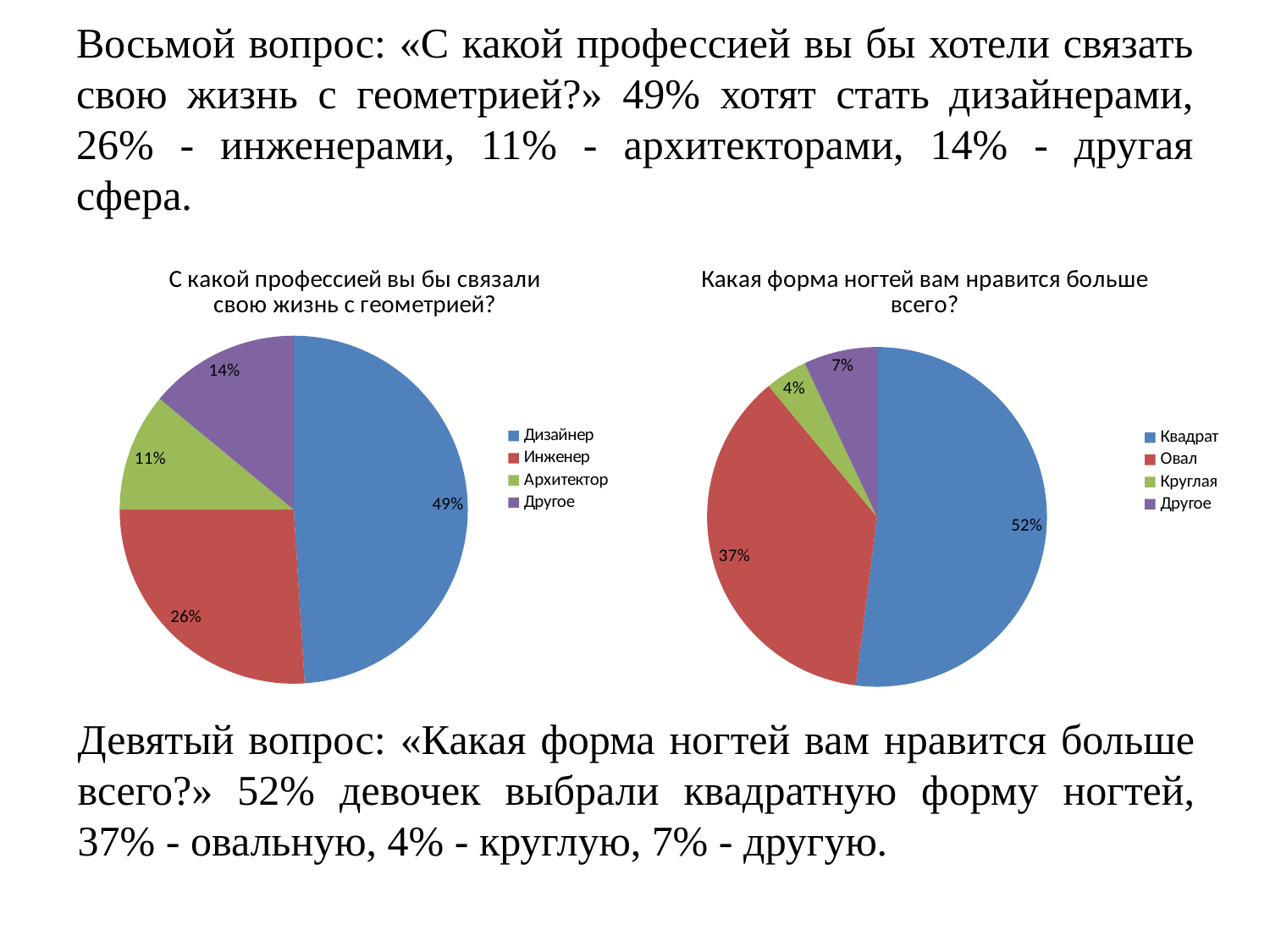
In the right chart (Какая форма ногтей вам нравится больше всего?), what is the difference between Квадрат and Овал? 15% In the right chart (Какая форма ногтей вам нравится больше всего?), what is the value for Овал? 37% In the right chart (Какая форма ногтей вам нравится больше всего?), what share of the pie is Квадрат? 52% In the left chart (С какой профессией вы бы связали свою жизнь с геометрией?), what colour is the Архитектор slice? Green In the left chart (С какой профессией вы бы связали свою жизнь с геометрией?), what is the difference between Дизайнер and Инженер? 23% In the right chart (Какая форма ногтей вам нравится больше всего?), which is larger, Круглая or Другое? Другое In the left chart (С какой профессией вы бы связали свою жизнь с геометрией?), how many categories does the legend list? 4 What type of chart is the right chart (Какая форма ногтей вам нравится больше всего?)? Pie chart In the left chart (С какой профессией вы бы связали свою жизнь с геометрией?), which category has the smallest slice? Архитектор In the left chart (С какой профессией вы бы связали свою жизнь с геометрией?), what is the value for Инженер? 26% In the right chart (Какая форма ногтей вам нравится больше всего?), which category has the smallest slice? Круглая In the left chart (С какой профессией вы бы связали свою жизнь с геометрией?), what share of the pie is Дизайнер? 49%